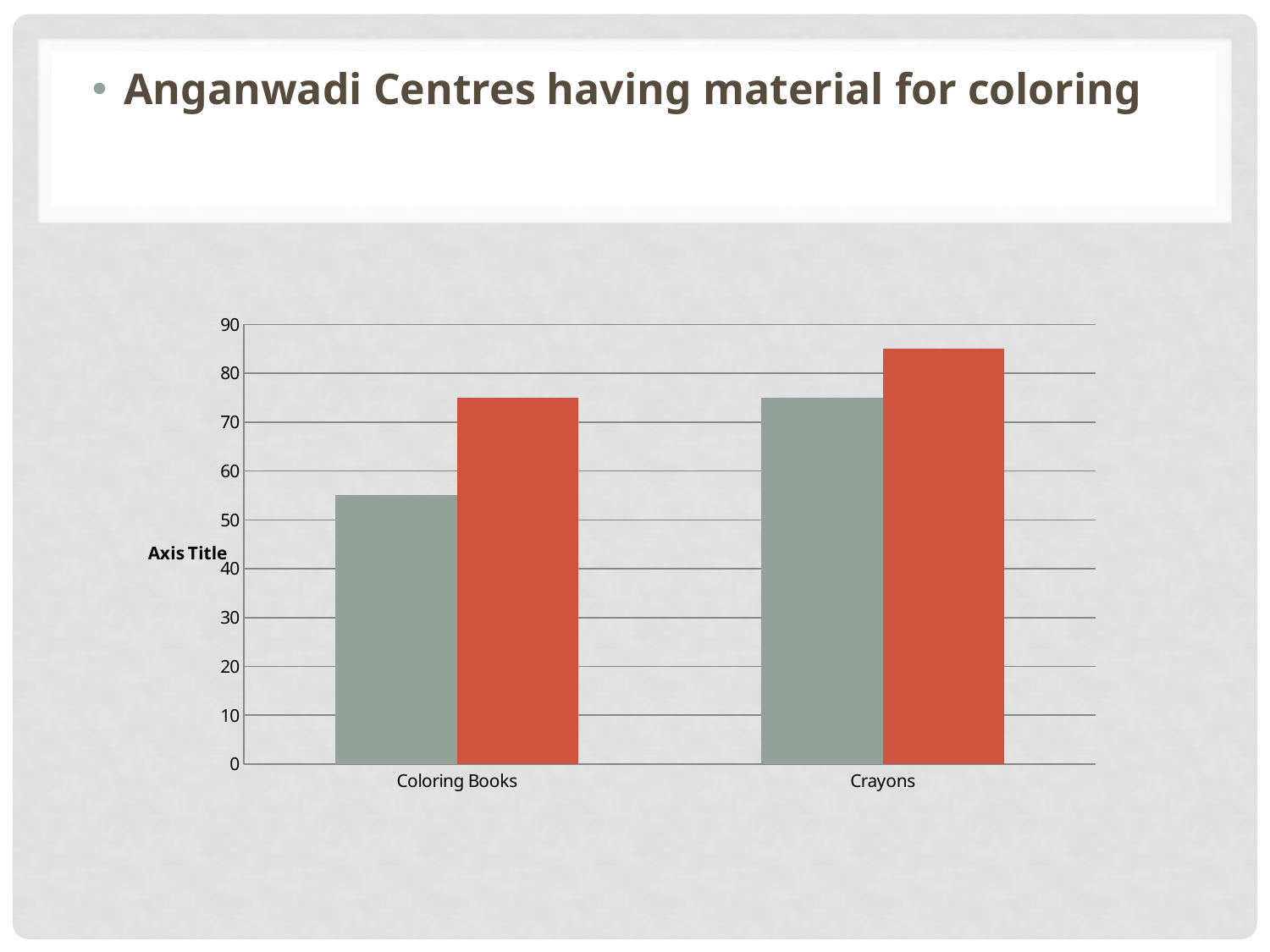
Is the value of the red bar for Coloring Books greater or less than 70? greater Is the value of the grey bar for Coloring Books greater or less than 60? less For Coloring Books, which bar is taller, the grey bar or the red bar? the red bar Which bar in the chart is the tallest overall? the red bar for Crayons Is the value of the grey bar for Coloring Books greater or less than 50? greater What kind of chart is shown on the slide? bar chart How many categories are shown on the x axis of the chart? 2 What is the label shown on the vertical axis of the chart? Axis Title Do the values rise or fall from Coloring Books to Crayons for both series? rise Which bar in the chart is the shortest overall? the grey bar for Coloring Books